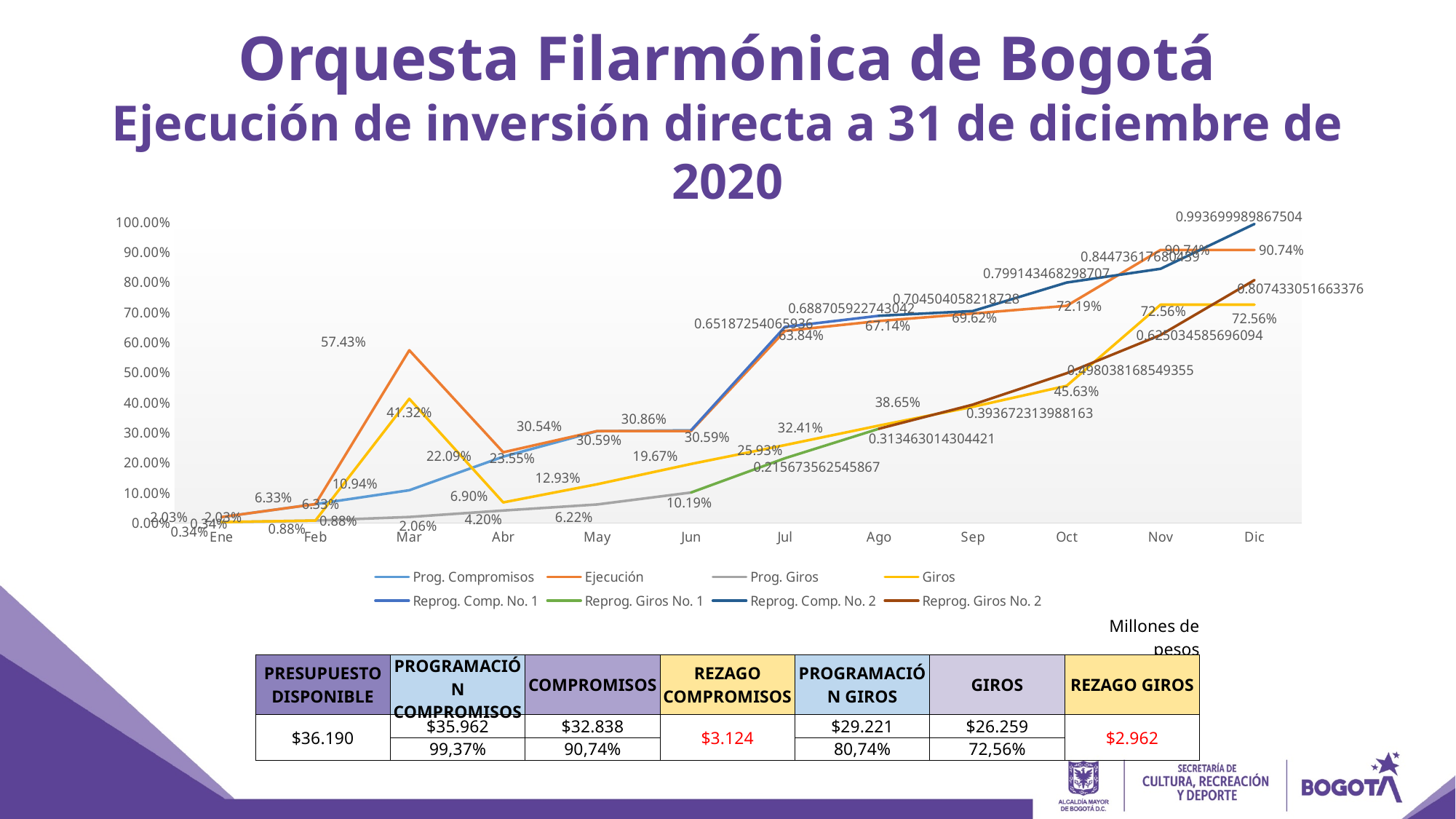
What is the value of the Reprog. Comp. No. 2 series in Dic? 0.993699989867504 How many months are shown along the x axis of the chart? 12 Which is larger in Dic, the Ejecución value or the Giros value? Ejecución What is the value of the Giros series in Dic? 72.56% What kind of chart is shown on the slide? line chart Is the value of Reprog. Comp. No. 2 in Dic greater or less than 90.00%? greater How many series does the chart legend list? 8 What is the value of the Giros series in Mar? 41.32% What is the value of the Ejecución series in Mar? 57.43% What is the value of the Giros series in Oct? 45.63% What is the value of the Ejecución series in Dic? 90.74% What is the difference between the Ejecución value and the Giros value in Dic? 18.18%